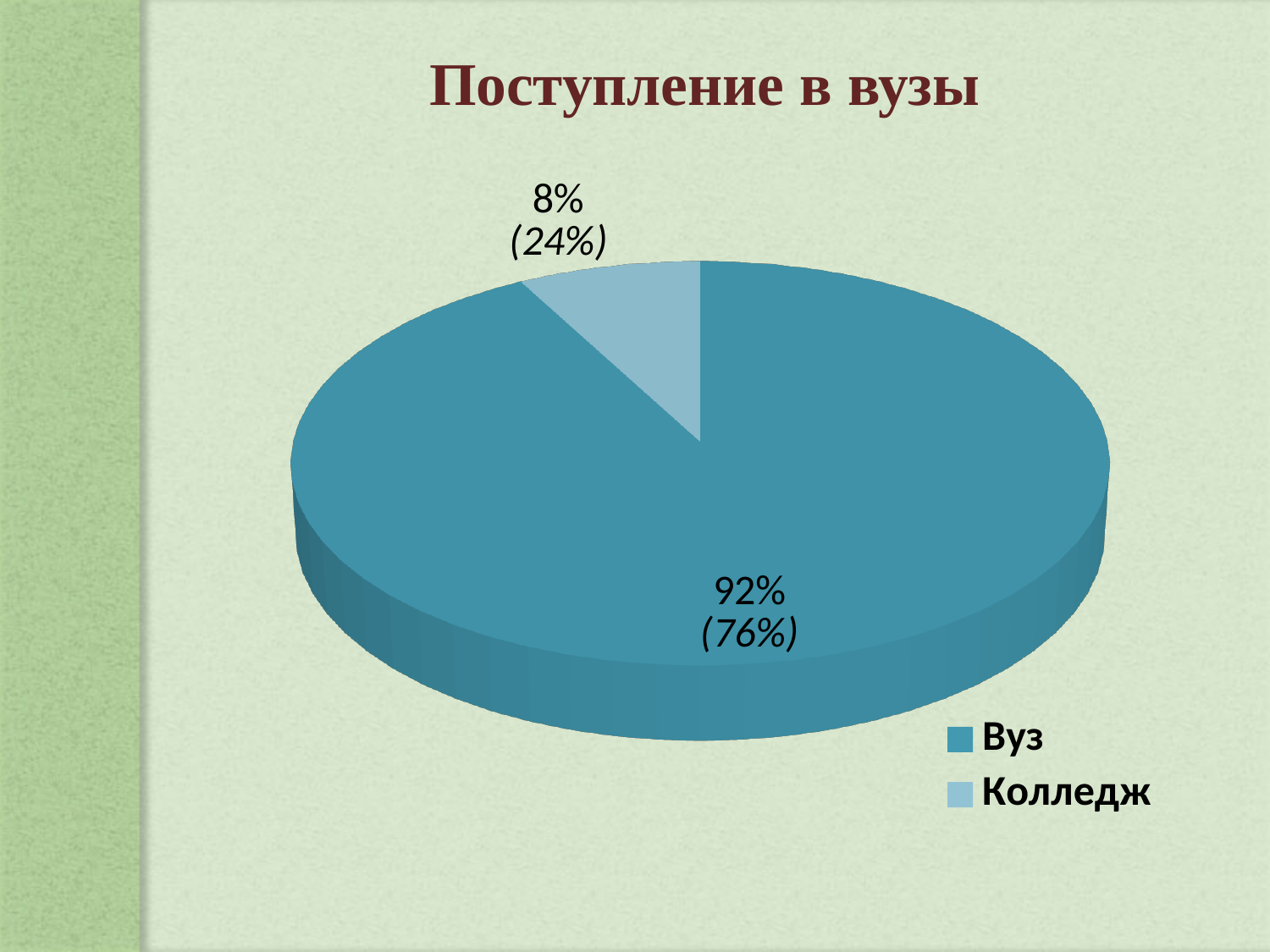
What is the difference in percentage points between the Вуз slice and the Колледж slice? 84 Which slice is the largest in the pie chart? Вуз Which slice is the smallest in the pie chart? Колледж How many slices does the pie chart have? 2 What value is printed in parentheses below the 92% label? (76%) How many entries does the legend list? 2 What value is printed in parentheses below the 8% label? (24%) What percentage is shown for the Колледж slice? 8% What percentage is shown for the Вуз slice? 92% What is the title of the chart? Поступление в вузы Which is larger, the Вуз slice or the Колледж slice? Вуз What kind of chart is shown on the slide? pie chart